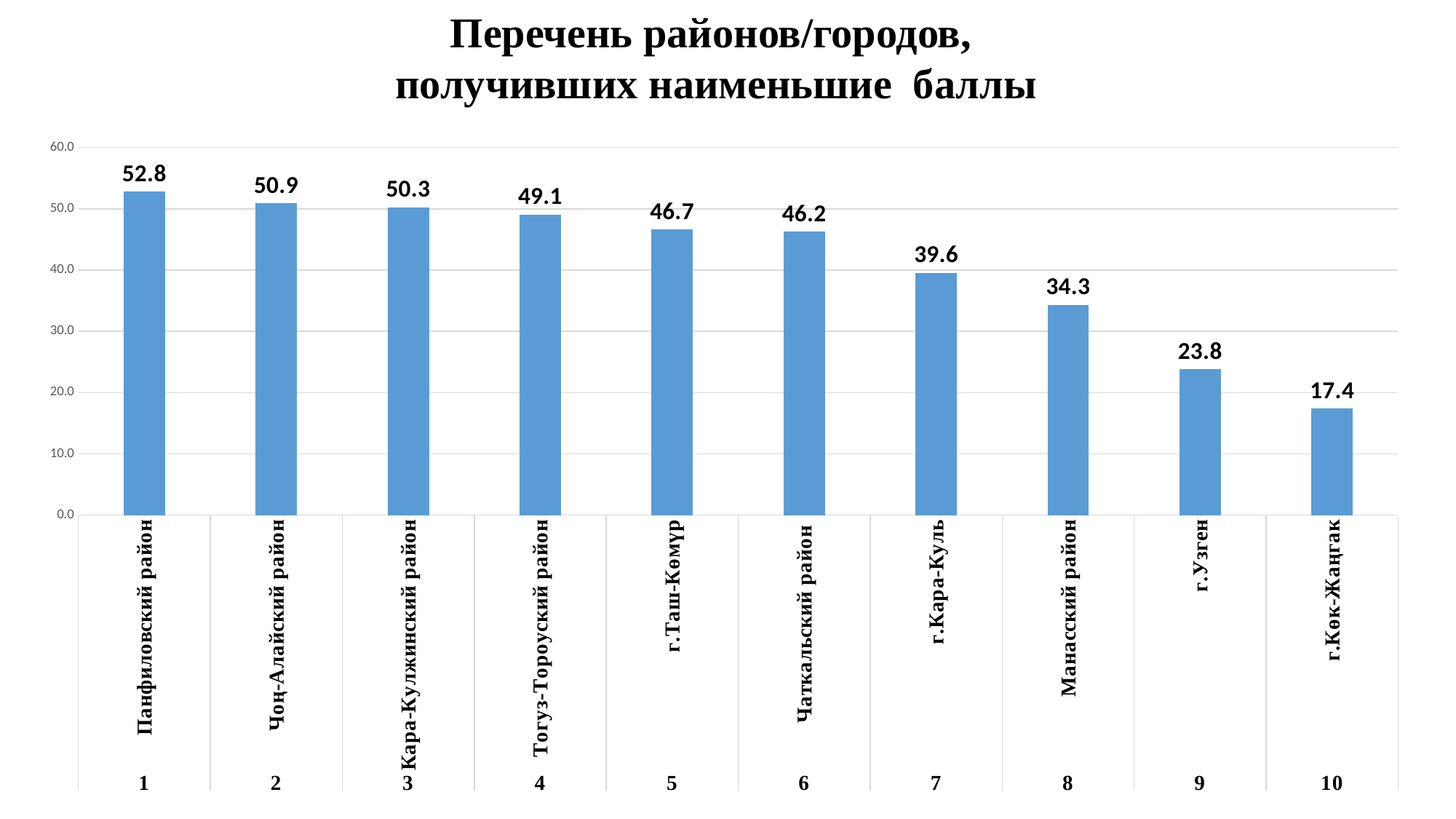
What is the value for г.Узген? 23.8 What kind of chart is shown on the slide? bar chart What is the difference between the values for г.Кара-Куль and Манасский район? 5.3 What is the difference between the values for Панфиловский район and г.Көк-Жаңгак? 35.4 Do the values rise or fall from left to right along the x axis? fall Is the value for Манасский район greater or less than 40.0? less What is the value for Панфиловский район? 52.8 What is the value for Чаткальский район? 46.2 Which category has the highest value? Панфиловский район Which category has the lowest value? г.Көк-Жаңгак How many categories are shown in the chart? 10 Which is larger, the value for г.Таш-Көмүр or the value for г.Узген? г.Таш-Көмүр